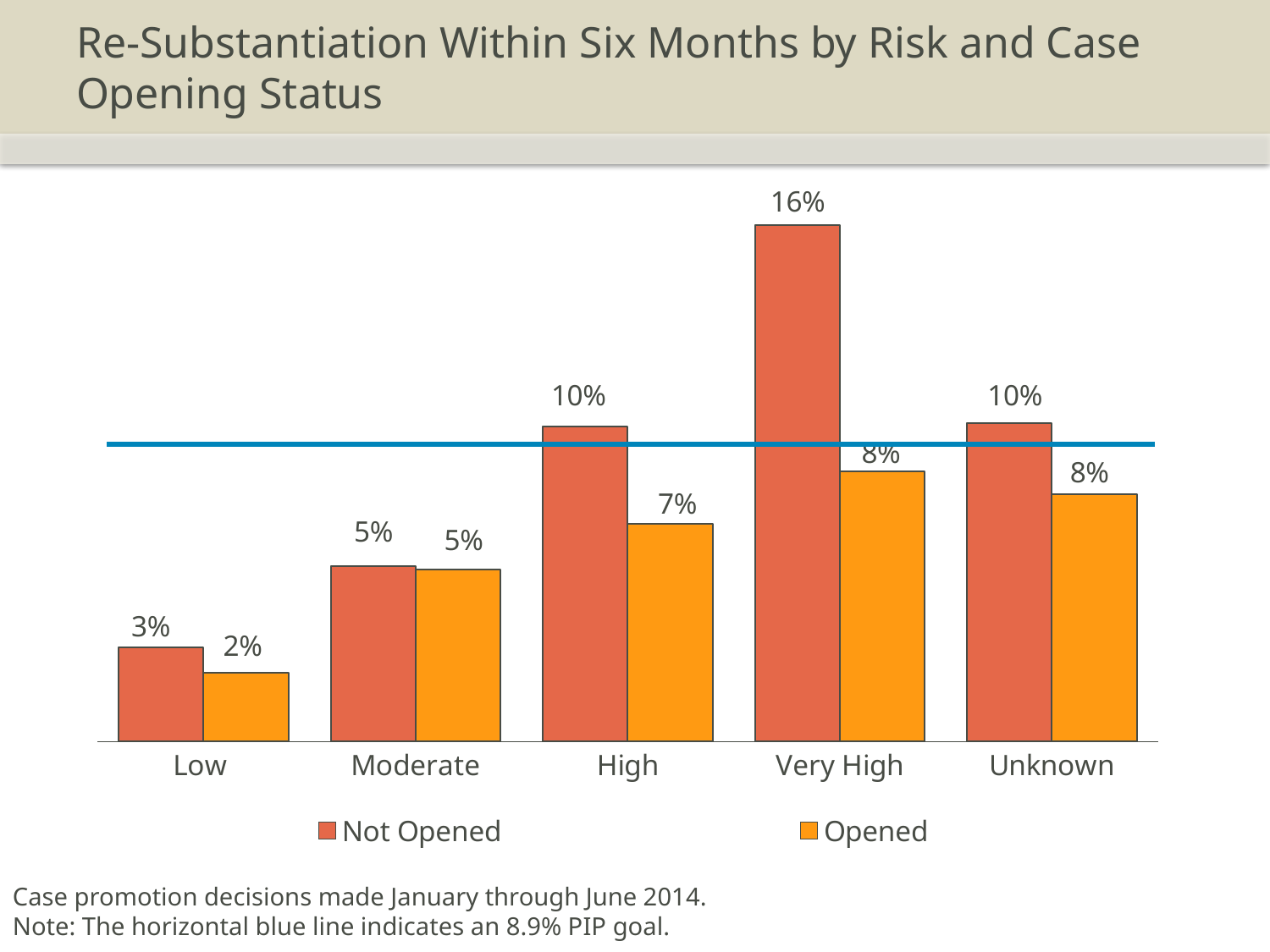
Which risk category has the lowest Opened value? Low What is the Not Opened value for the Unknown category? 10% What is the Opened value for the Low risk category? 2% What is the Opened value for the High risk category? 7% What goal does the horizontal blue line indicate? 8.9% PIP goal How many risk categories are shown on the x axis? 5 What is the difference between the Not Opened and Opened values for the Very High category? 8% Which risk category has the highest Not Opened value? Very High How many series does the legend list? 2 What is the Not Opened value for the Very High risk category? 16% Which is larger for the High category, the Not Opened value or the Opened value? Not Opened What kind of chart is shown on the slide? Bar chart